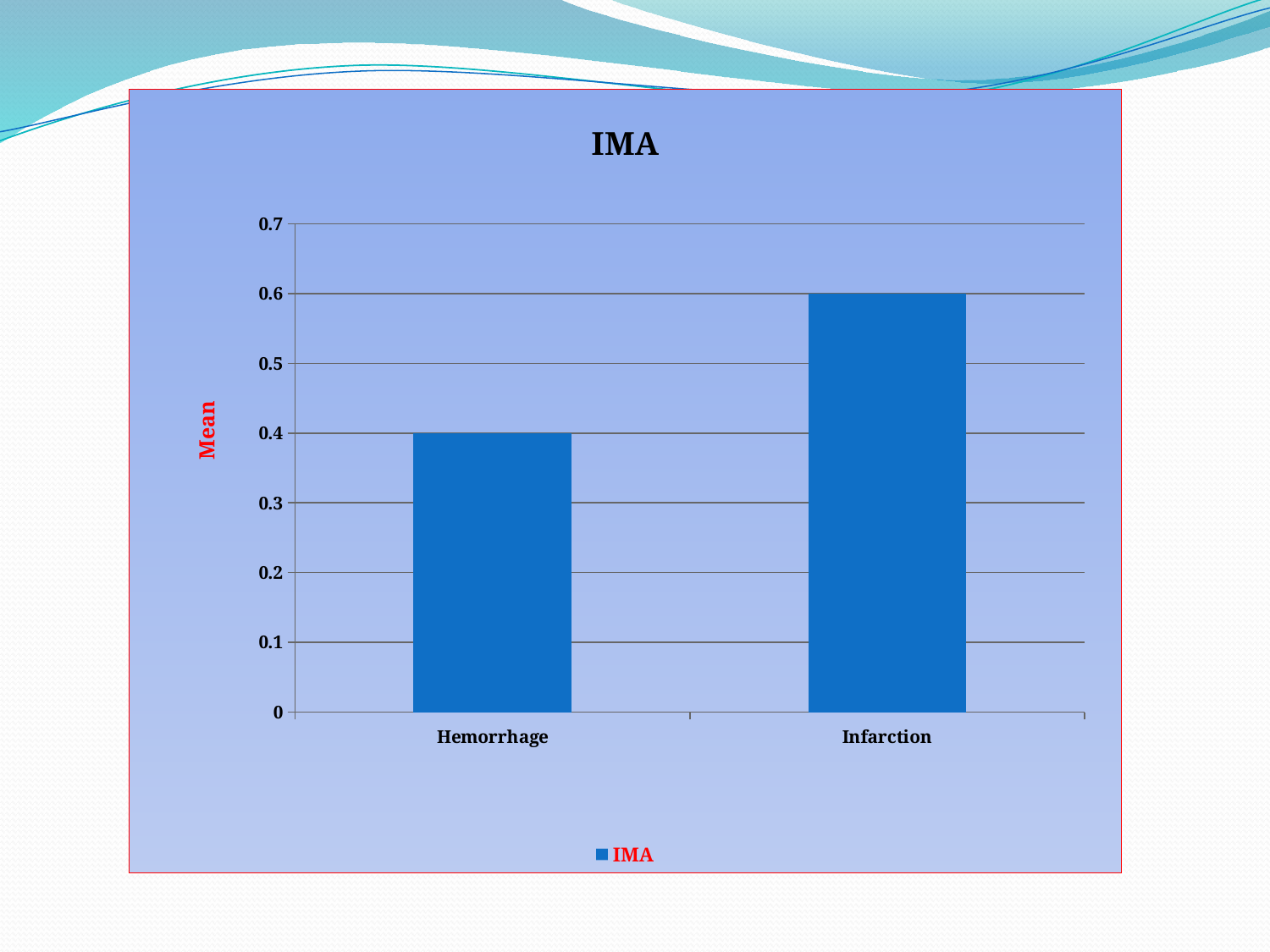
What is the label of the y axis? Mean What is the mean IMA value for Infarction? 0.6 Is the mean IMA value for Infarction greater or less than 0.5? greater How many categories are shown on the x axis of the chart? 2 Is the mean IMA value for Hemorrhage greater or less than 0.5? less What kind of chart is shown on the slide? Bar chart What is the difference between the mean IMA values for Infarction and Hemorrhage? 0.2 Which has a larger mean IMA value, Hemorrhage or Infarction? Infarction Which category has the lowest mean IMA value? Hemorrhage What is the mean IMA value for Hemorrhage? 0.4 Which category has the highest mean IMA value? Infarction How many series does the legend list? 1